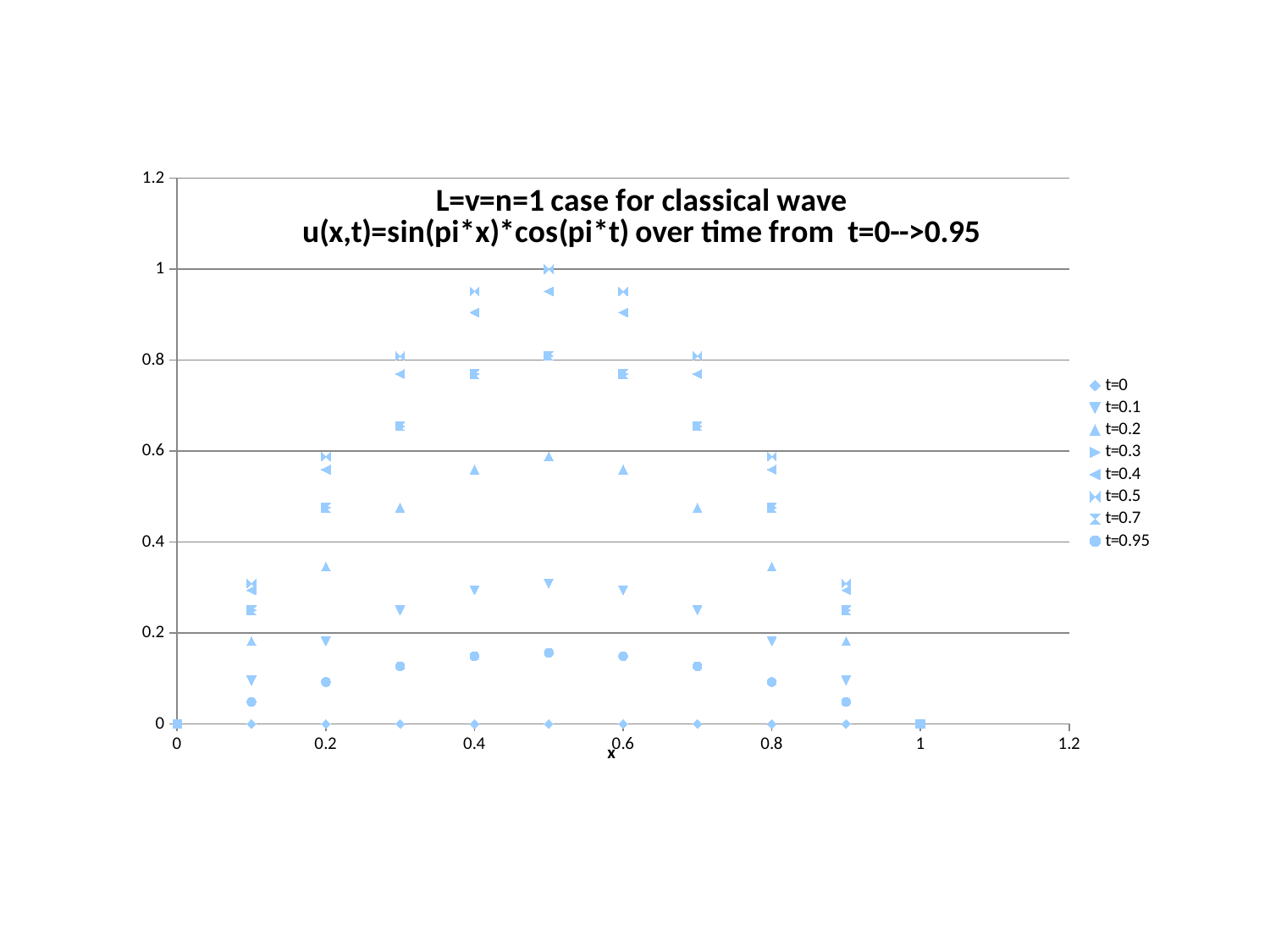
How many x positions are plotted for each series? 11 What is the label of the horizontal axis? x Is the value of the t=0.2 series at x=0.5 greater or less than 0.4? greater Is the value of the t=0.95 series at x=0.1 greater or less than 0.2? less At x=0.5, which series has the larger value, t=0.2 or t=0.1? t=0.2 How many series does the legend list? 8 At which x value does the t=0.2 series reach its highest point? 0.5 Is the value of the t=0.95 series at x=0.5 greater or less than 0.2? less What is the first line of the chart title? L=v=n=1 case for classical wave Do the values of the t=0.2 series rise or fall as x goes from 0 to 0.5? rise What kind of chart is shown on the slide? scatter chart